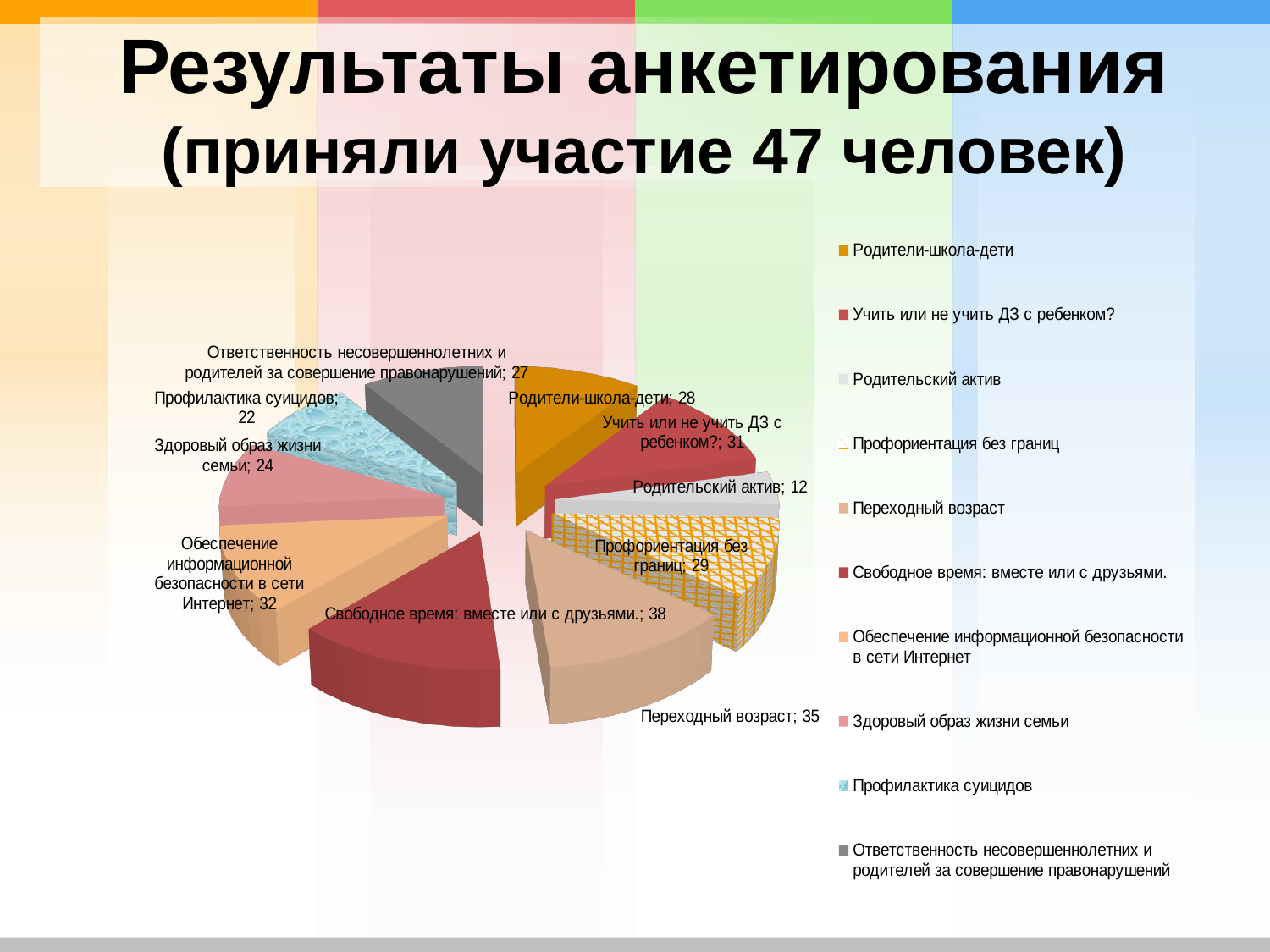
Which category has the smallest slice in the pie chart? Родительский актив What is the difference between the values for "Свободное время: вместе или с друзьями." and "Родительский актив"? 26 What value is shown for the slice "Обеспечение информационной безопасности в сети Интернет"? 32 Which category has the largest slice in the pie chart? Свободное время: вместе или с друзьями. What value is shown for the slice "Профилактика суицидов"? 22 Which is larger: the value for "Переходный возраст" or the value for "Профориентация без границ"? Переходный возраст What value is shown for the slice "Переходный возраст"? 35 According to the slide title, how many people took part in the survey? 47 What is the difference between the values for "Учить или не учить ДЗ с ребенком?" and "Родители-школа-дети"? 3 How many categories (slices) does the pie chart have? 10 What value is shown for the slice "Родительский актив"? 12 What type of chart is shown on the slide? Pie chart